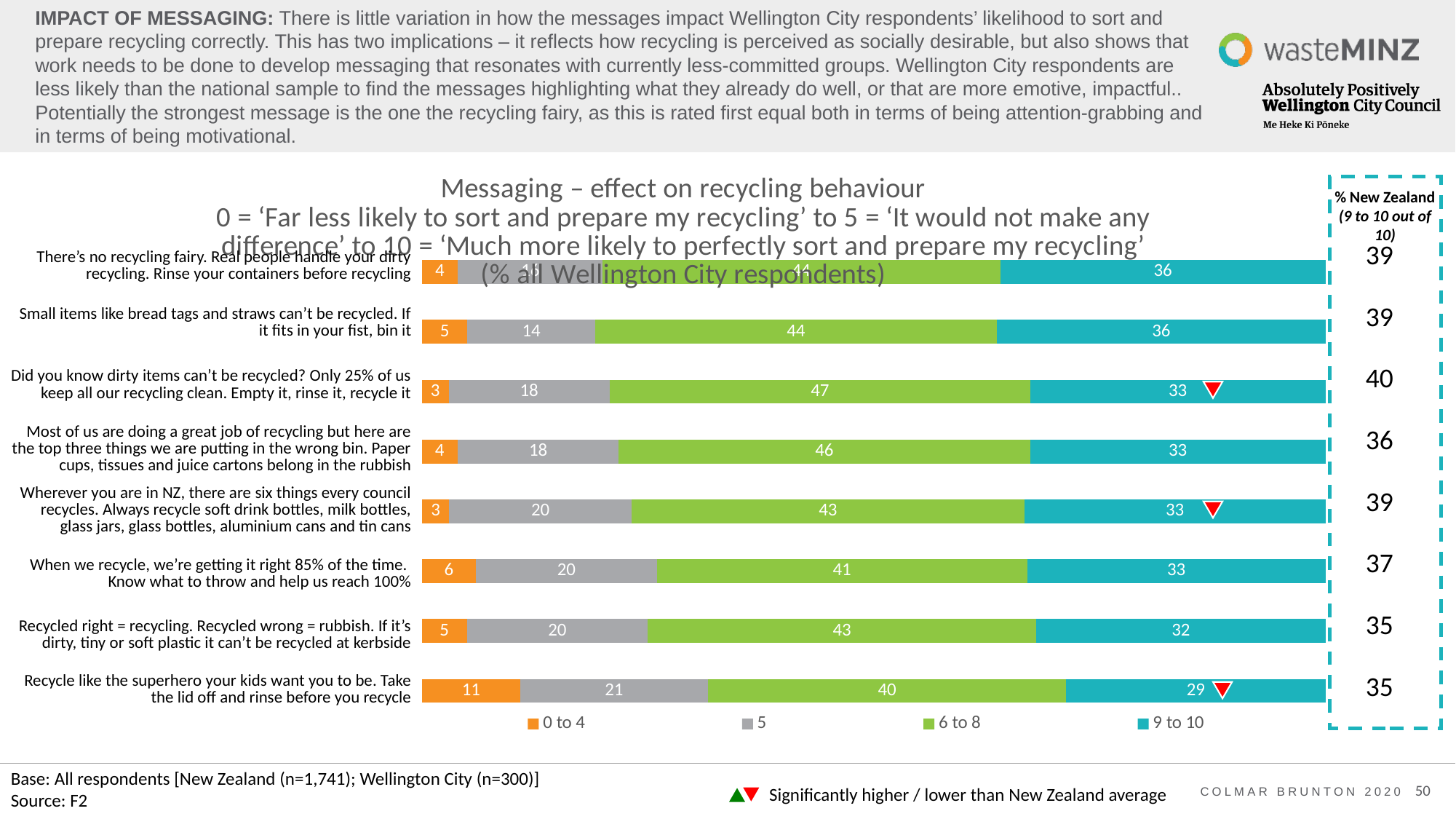
What is the total of the stacked bar for 'Small items like bread tags and straws can't be recycled'? 99 What is the difference between the '9 to 10' values for 'Small items like bread tags and straws can't be recycled' and 'Recycle like the superhero your kids want you to be'? 7 What is the '6 to 8' value for the message 'Did you know dirty items can't be recycled?'? 47 What is the '5' value for the message 'Wherever you are in NZ, there are six things every council recycles'? 20 Which message has the highest '6 to 8' value? Did you know dirty items can't be recycled? Only 25% of us keep all our recycling clean. Empty it, rinse it, recycle it How many series does the legend list? 4 What is the '9 to 10' value for the message 'Recycle like the superhero your kids want you to be'? 29 What is the '0 to 4' value for the message 'Recycle like the superhero your kids want you to be'? 11 How many messages (bars) are plotted in the chart? 8 Which has the larger '0 to 4' value: 'When we recycle, we're getting it right 85% of the time' or 'Recycled right = recycling. Recycled wrong = rubbish'? When we recycle, we're getting it right 85% of the time Which message has the lowest '9 to 10' value? Recycle like the superhero your kids want you to be. Take the lid off and rinse before you recycle What kind of chart is shown on the slide? Bar chart